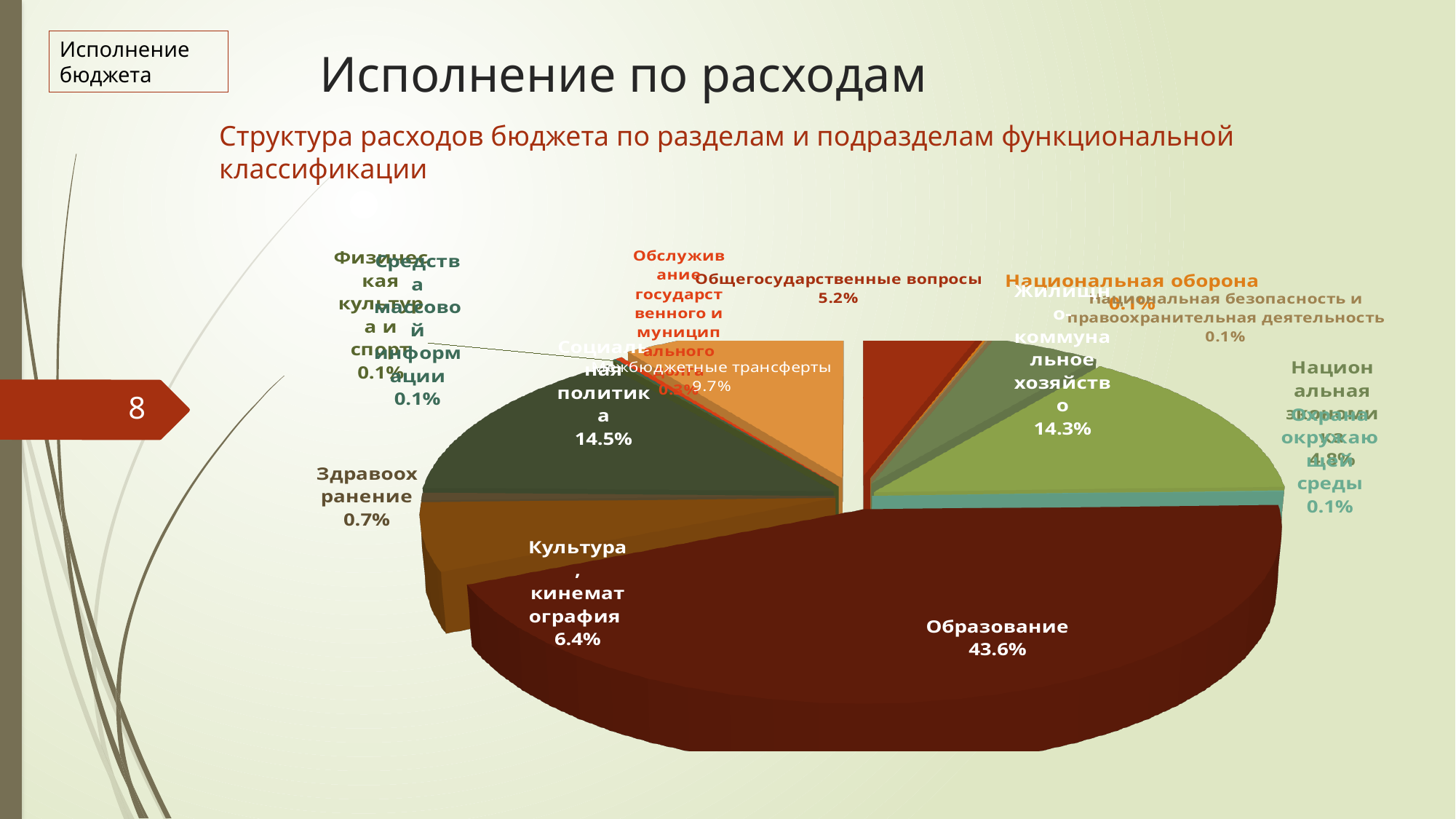
What is the value shown for Жилищно-коммунальное хозяйство? 14.3% What is the value shown for Межбюджетные трансферты? 9.7% What is the subtitle describing the chart on the slide? Структура расходов бюджета по разделам и подразделам функциональной классификации What is the value shown for Здравоохранение? 0.7% What type of chart is shown on the slide? Pie chart What is the difference in percentage points between Образование and Социальная политика? 29.1 Which is larger: Социальная политика or Культура, кинематография? Социальная политика What is the value shown for Культура, кинематография? 6.4% What is the value shown for Общегосударственные вопросы? 5.2% Which category has the largest share of the pie? Образование What share of expenditures does Образование account for? 43.6% What is the value shown for Социальная политика? 14.5%